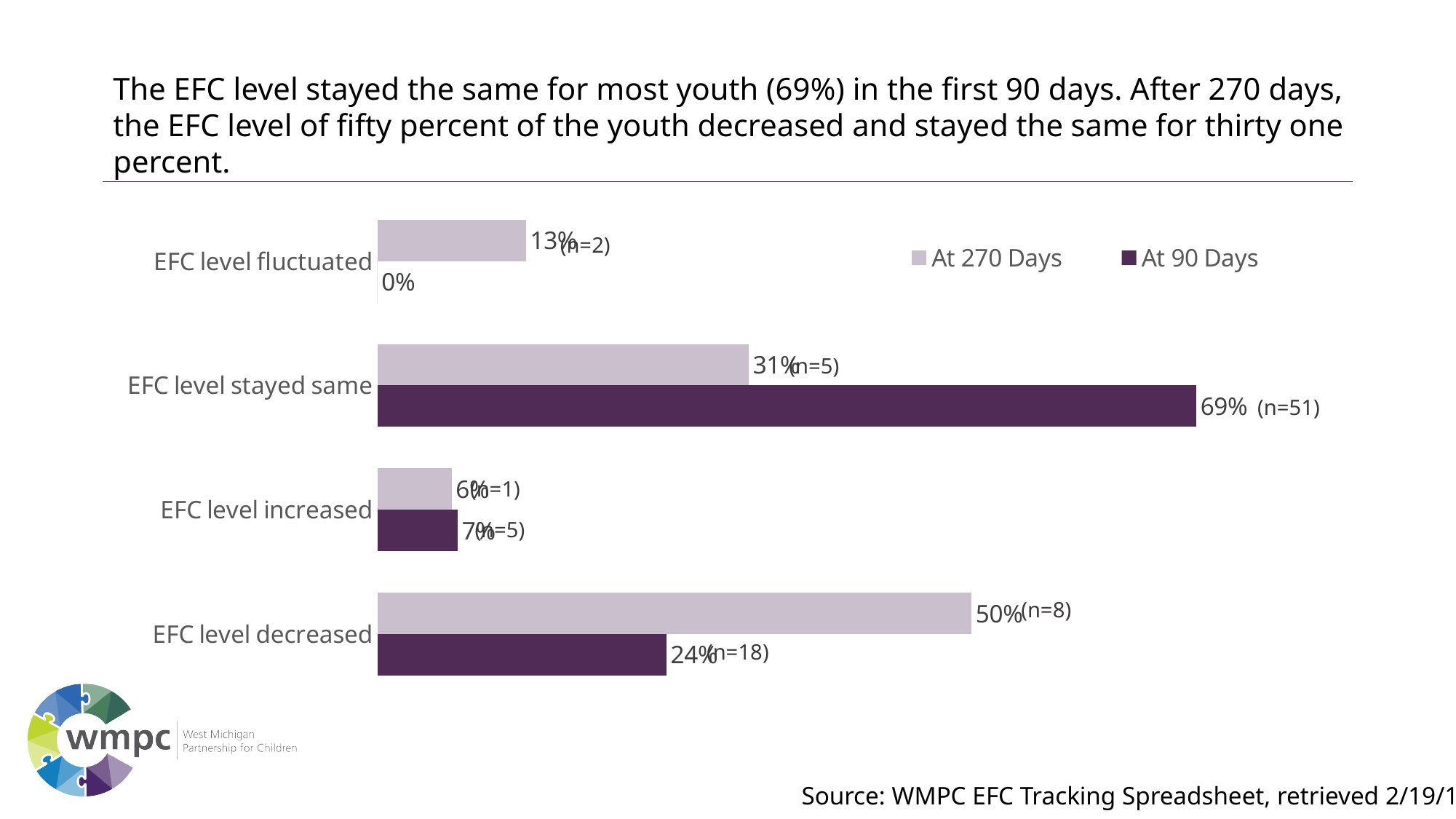
What are the two series named in the legend? At 270 Days and At 90 Days How many series does the legend list? 2 What is the value for 'EFC level increased' in the 'At 270 Days' series? 6% Which category has the highest value in the 'At 90 Days' series? EFC level stayed same How many categories are shown on the chart? 4 What kind of chart is shown on the slide? bar chart Which category has the lowest value in the 'At 270 Days' series? EFC level increased For 'EFC level decreased', which series has the larger value, 'At 270 Days' or 'At 90 Days'? At 270 Days What is the value for 'EFC level decreased' in the 'At 270 Days' series? 50% What is the value for 'EFC level fluctuated' in the 'At 90 Days' series? 0% What is the value for 'EFC level stayed same' in the 'At 90 Days' series? 69% What is the difference between the 'At 90 Days' and 'At 270 Days' values for 'EFC level stayed same'? 38%